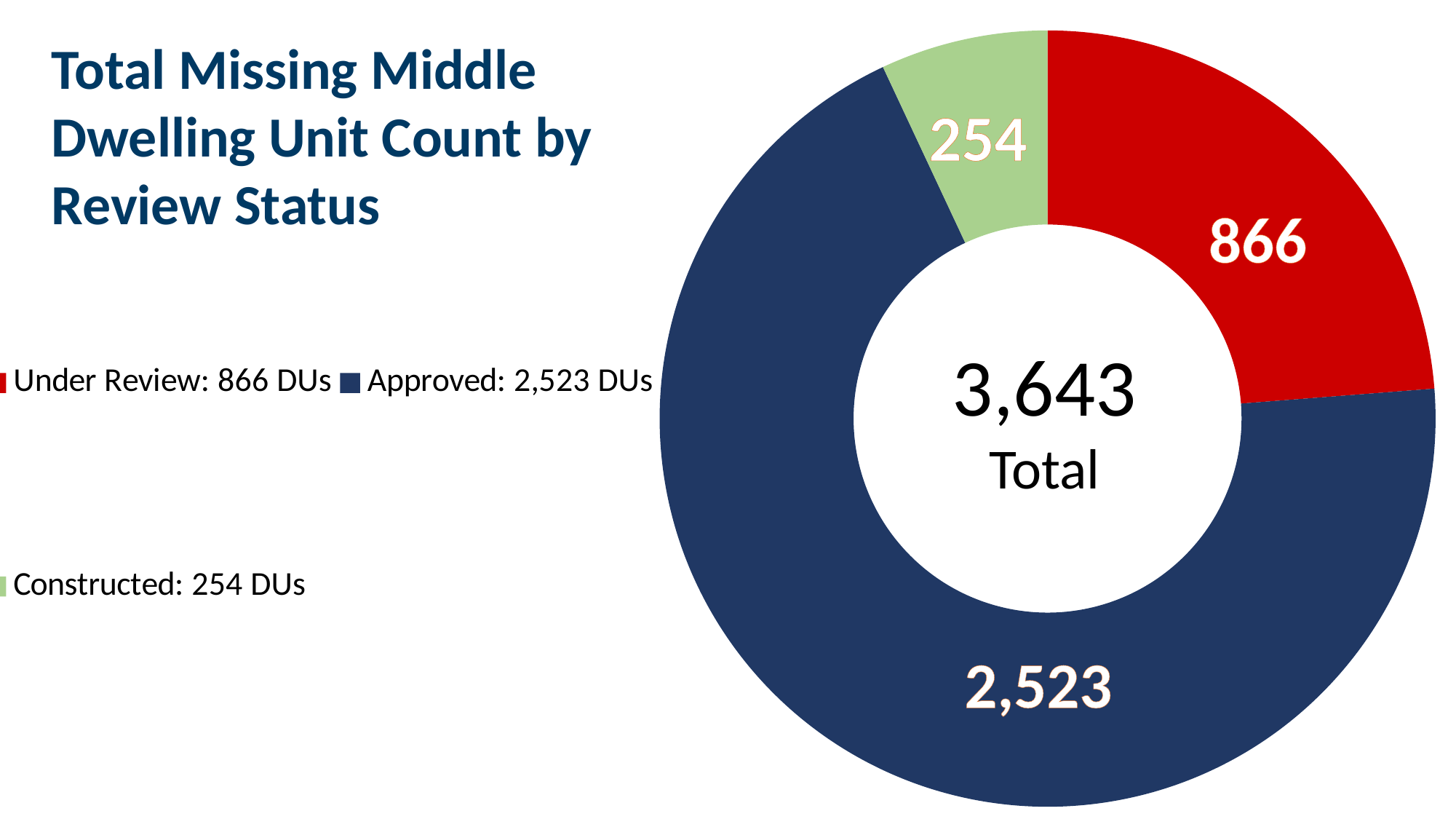
Which review status has the lowest dwelling unit count? Constructed What is the dwelling unit count for Constructed? 254 What colour represents the Approved category in the chart? Dark blue How many review status categories are shown in the chart? 3 What total dwelling unit count is shown in the centre of the chart? 3,643 What is the dwelling unit count for Approved? 2,523 Which review status has the highest dwelling unit count? Approved What is the difference between the Approved and Under Review dwelling unit counts? 1,657 What kind of chart is shown on the slide? Pie chart (doughnut) Which is larger, the Under Review count or the Constructed count? Under Review What is the difference between the Under Review and Constructed dwelling unit counts? 612 What is the dwelling unit count for Under Review? 866